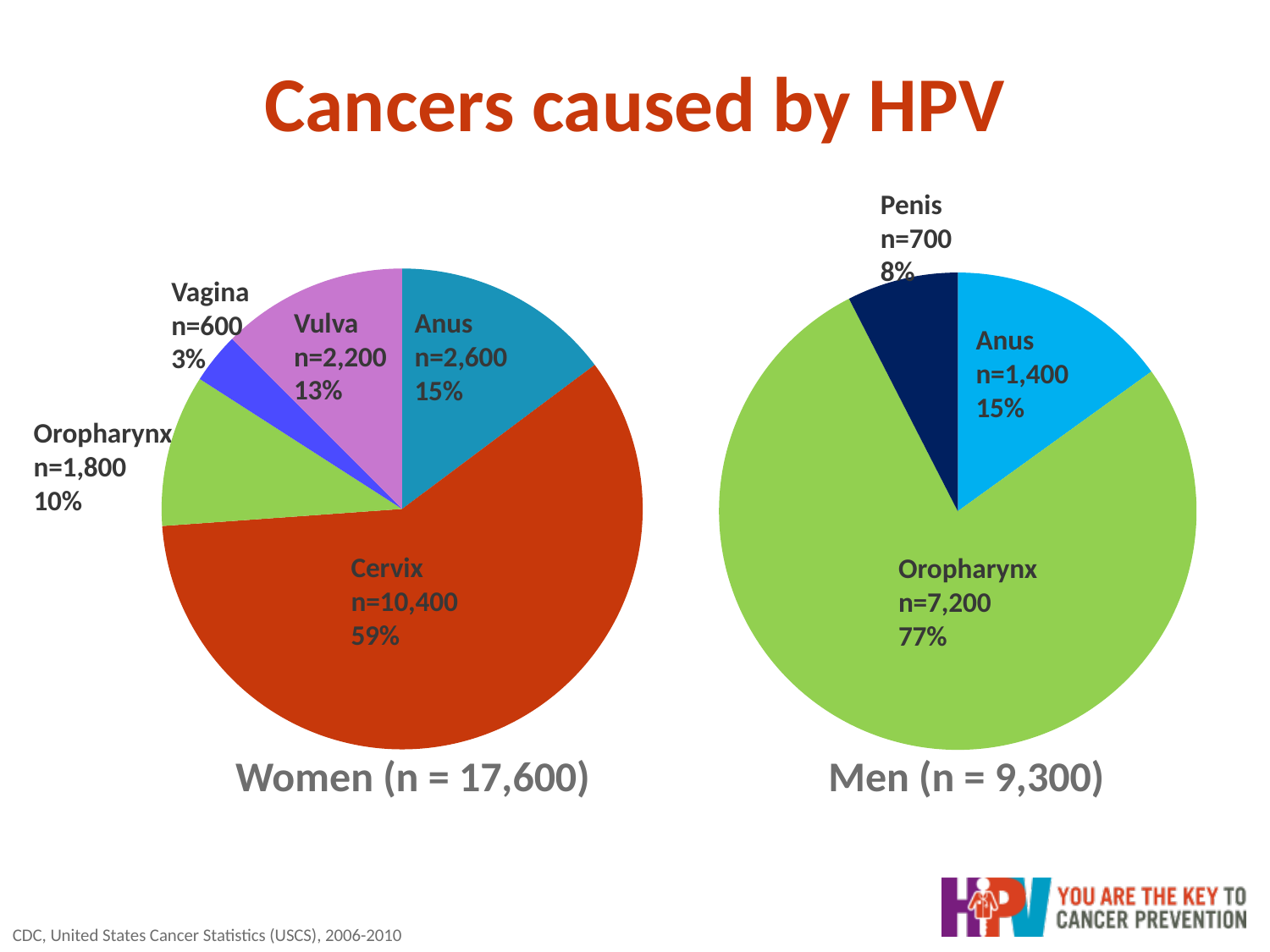
In the Men pie chart, which cancer site has the smallest slice? Penis In the Women pie chart, which cancer site has the smallest slice? Vagina In the Men pie chart, what is the number of penis cancers? n=700 How many slices does the Women pie chart have? 5 In the Women pie chart, what is the number of cervix cancers? n=10,400 In the Men pie chart, what is the difference between the number of oropharynx cancers and the number of anus cancers? 5,800 In the Women pie chart, what percentage share does the Vulva slice have? 13% What type of chart is used on this slide? Pie chart In the Men pie chart, what percentage share does the Oropharynx slice have? 77% Which is larger: the number of oropharynx cancers in the Women chart or in the Men chart? Men In the Women pie chart, what is the difference between the number of anus cancers and the number of vulva cancers? 400 In the Women pie chart, which cancer site has the largest slice? Cervix